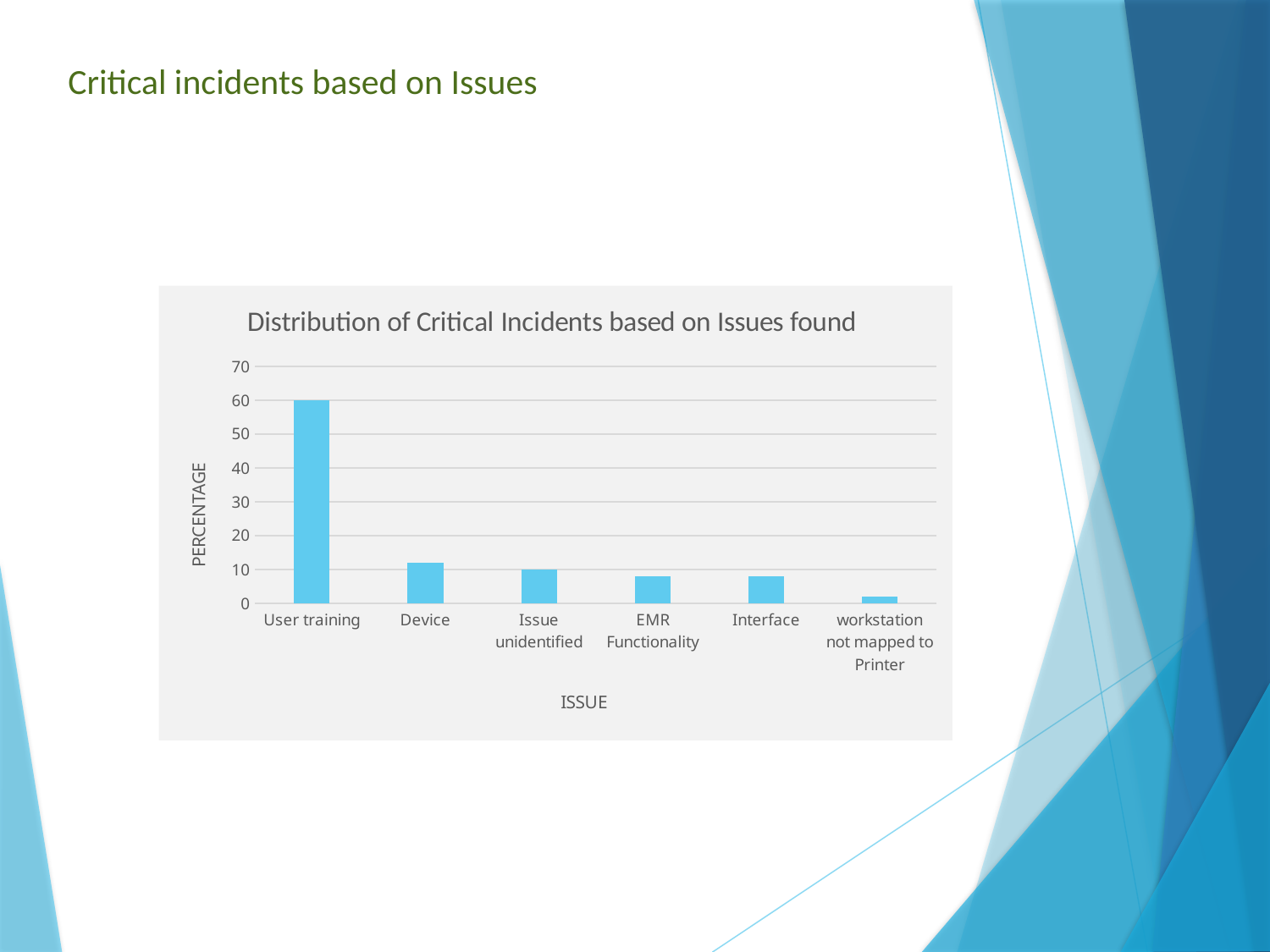
What kind of chart is shown on the slide? bar chart Which issue has the lowest percentage of critical incidents? workstation not mapped to Printer How many issue categories are plotted on the x axis? 6 Which is larger, the value for Device or the value for Interface? Device What is the label of the vertical axis? PERCENTAGE Is the value for Device greater or less than 20? less Is the value for workstation not mapped to Printer greater or less than 10? less What is the percentage value for Issue unidentified? 10 Which issue has the highest percentage of critical incidents? User training Do the values generally rise or fall moving from left to right along the x axis? fall What is the percentage value for User training? 60 What is the title of the chart? Distribution of Critical Incidents based on Issues found